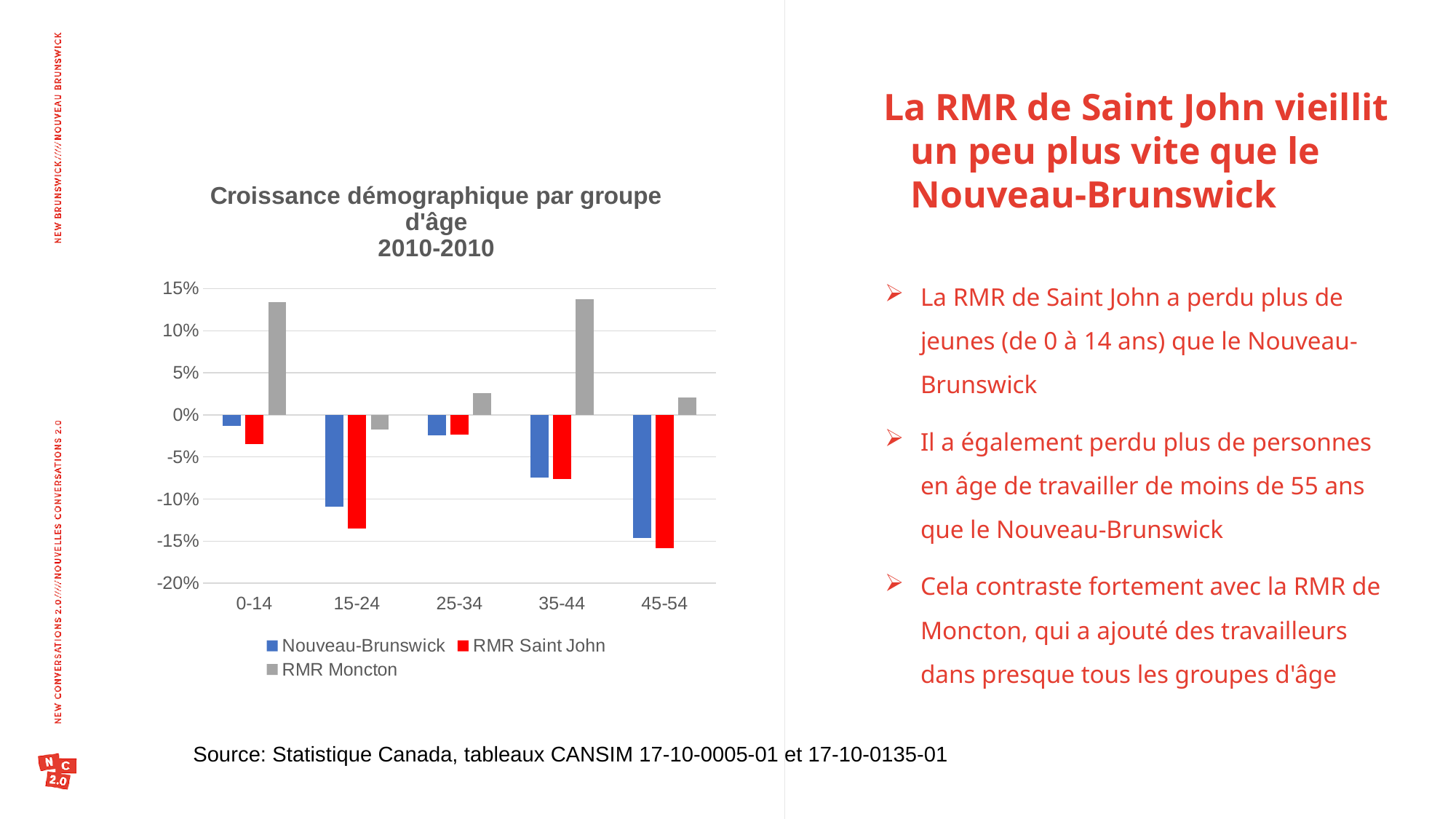
Is the value for RMR Moncton in the 25-34 age group greater or less than 0%? greater What colour are the bars for RMR Saint John in the chart? red Is the value for Nouveau-Brunswick in the 15-24 age group greater or less than -5%? less For which age group is the RMR Saint John value the lowest? 45-54 How many age groups are shown on the x axis of the chart? 5 How many series does the chart's legend list? 3 Is the value for RMR Saint John in the 45-54 age group greater or less than -10%? less For which age group is the Nouveau-Brunswick value the lowest? 45-54 In the 0-14 age group, which is larger: the value for RMR Moncton or for RMR Saint John? RMR Moncton In the 15-24 age group, which is larger: the value for Nouveau-Brunswick or for RMR Saint John? Nouveau-Brunswick What kind of chart is shown on the slide? bar chart